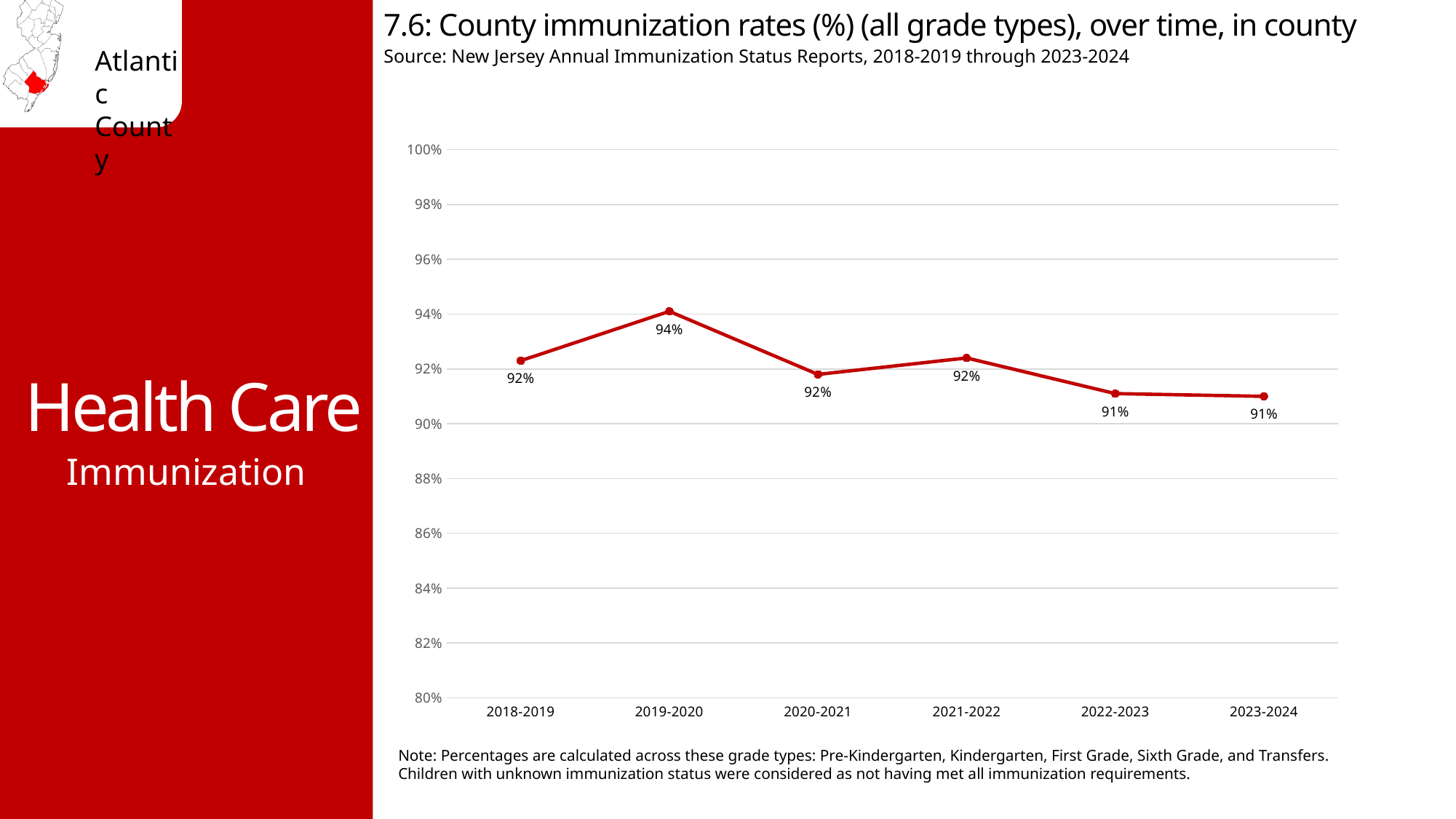
What type of chart is shown on the slide? Line chart What was the county immunization rate in 2022-2023? 91% Did the county immunization rate rise or fall from 2019-2020 to 2023-2024? Fall What was the county immunization rate in 2023-2024? 91% Which school year had the highest county immunization rate? 2019-2020 How many school years are plotted on the chart? 6 What is the source cited for the chart data? New Jersey Annual Immunization Status Reports, 2018-2019 through 2023-2024 Is the value for 2023-2024 greater or less than 92%? less What was the county immunization rate in 2018-2019? 92% By how many percentage points did the immunization rate in 2019-2020 exceed the rate in 2018-2019? 2 percentage points Which year had a higher immunization rate, 2019-2020 or 2022-2023? 2019-2020 What was the county immunization rate in 2019-2020? 94%